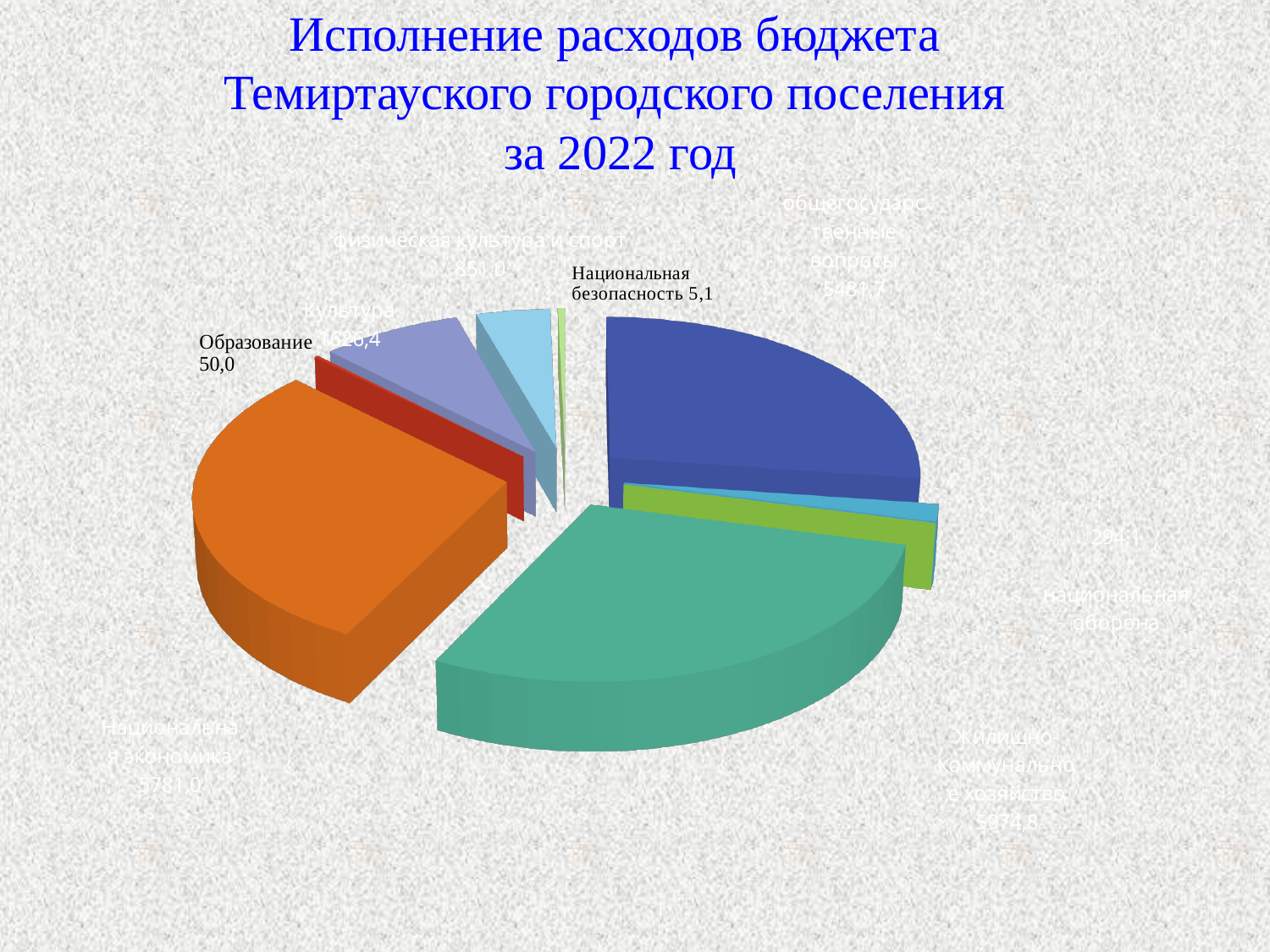
Which is larger, the value for Образование or the value for Национальная безопасность? Образование Which category has the smallest slice in the pie chart? Национальная безопасность What is the value shown for Образование? 50,0 What kind of chart is shown on the slide? Pie chart What is the value shown for Национальная безопасность? 5,1 Which year does the chart title refer to? 2022 What is the title of the chart on the slide? Исполнение расходов бюджета Темиртауского городского поселения за 2022 год What is the difference between the values for Образование (50,0) and Национальная безопасность (5,1)? 44,9